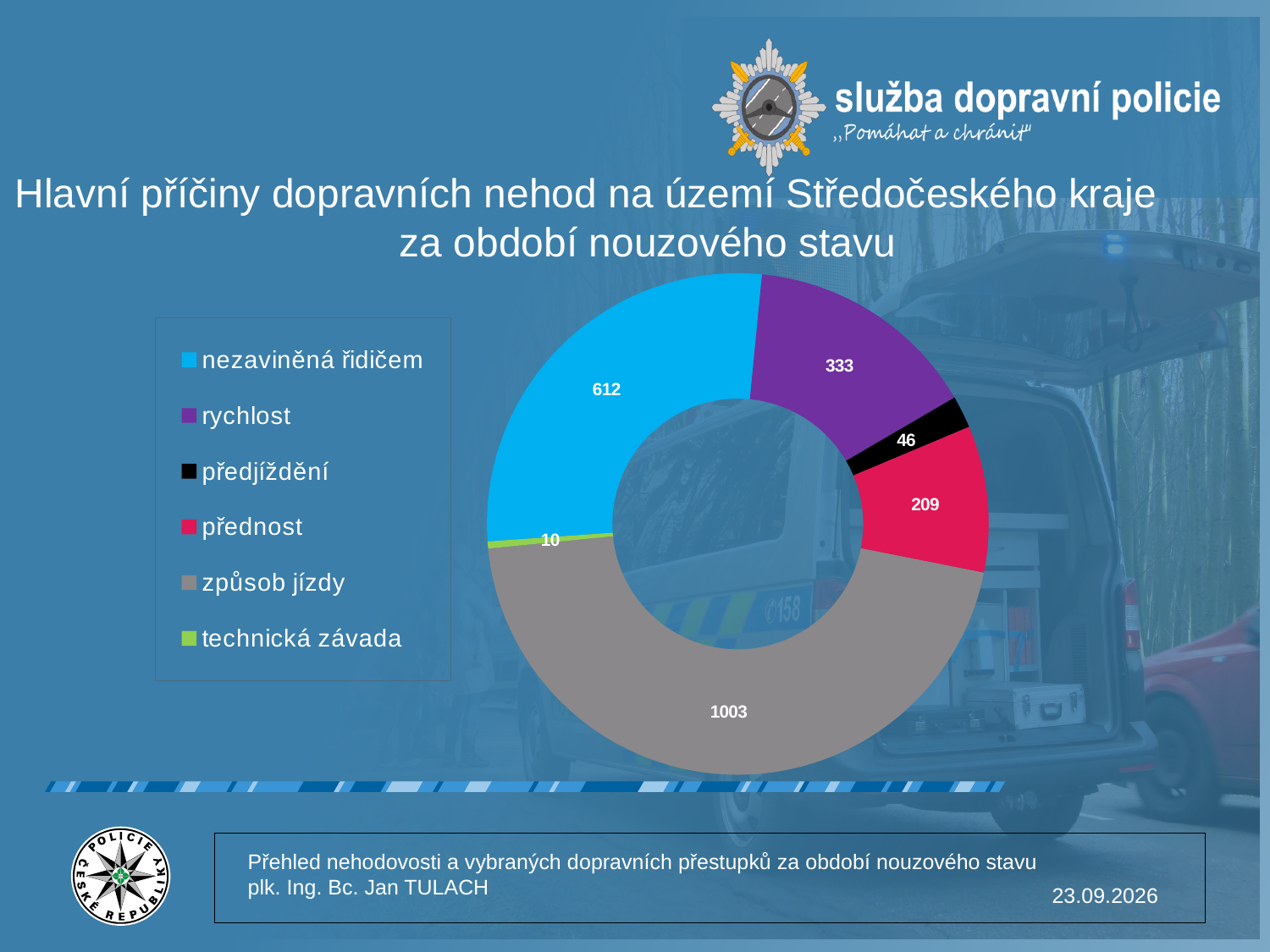
Which category has the smallest value? technická závada What value is shown for způsob jízdy? 1003 Which category has the largest value? způsob jízdy What value is shown for rychlost? 333 What value is shown for technická závada? 10 How many categories does the chart show? 6 Which is larger, the value for přednost or the value for předjíždění? přednost What value is shown for předjíždění? 46 What is the difference between the values for rychlost and přednost? 124 What kind of chart is shown on the slide? pie (doughnut) chart What is the difference between the values for způsob jízdy and nezaviněná řidičem? 391 What colour represents rychlost in the chart? purple